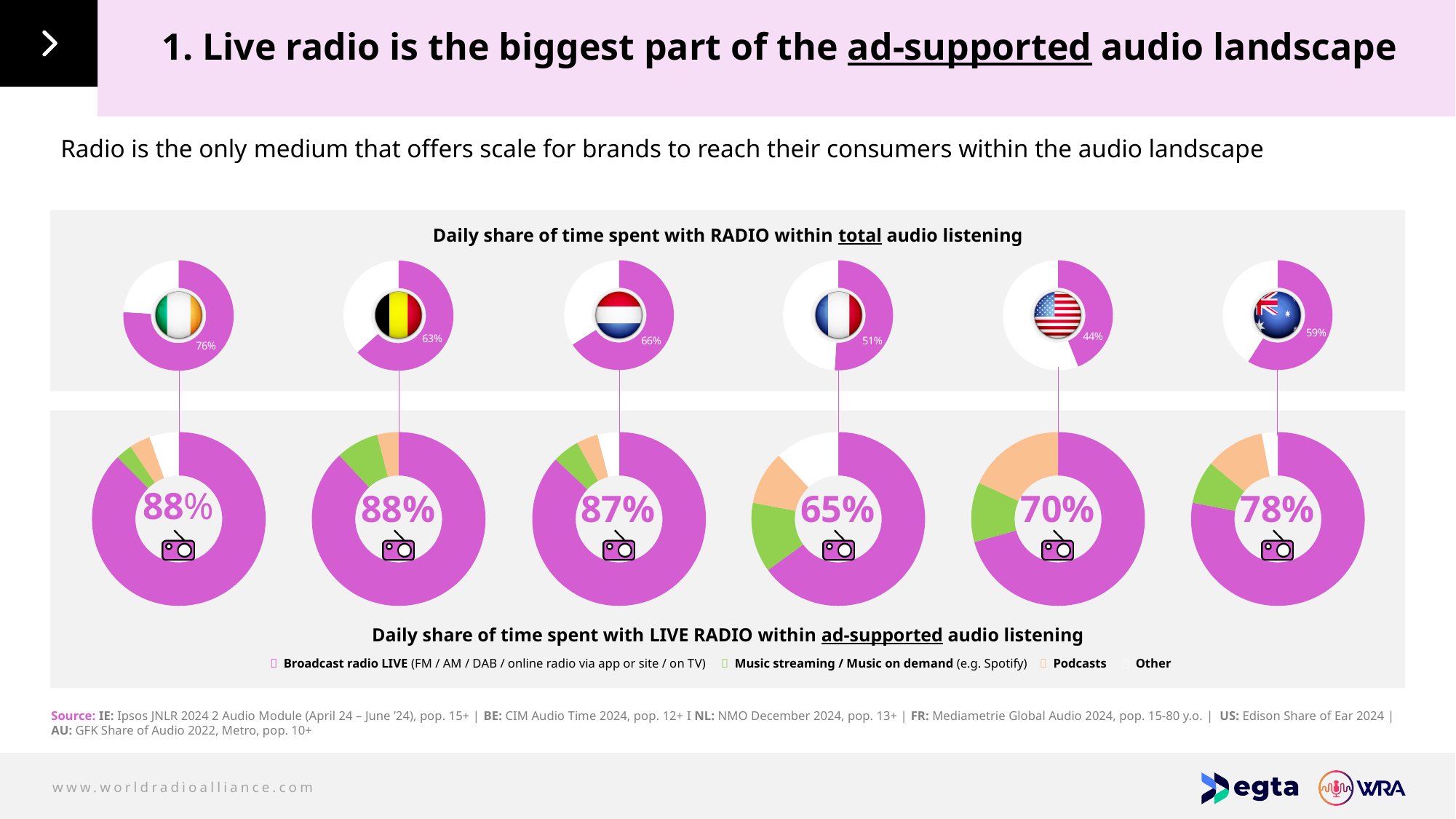
In the bottom row of charts (LIVE RADIO within ad-supported audio listening), which country has the lowest share? France In the top row of charts (RADIO within total audio listening), which country has the lowest share? United States In the top row of charts (RADIO within total audio listening), which country has the highest share? Ireland In the bottom row of charts (LIVE RADIO within ad-supported audio listening), what is the value shown for Australia? 78% What kind of chart is used to show the daily share of time spent with live radio within ad-supported audio listening? Donut (pie) chart In the top row of charts (Daily share of time spent with RADIO within total audio listening), what is the value shown for Ireland? 76% How many categories does the legend below the bottom row of charts list? 4 In the top row of charts (RADIO within total audio listening), what is the value shown for the United States? 44% In the bottom row of charts, what is the difference between the live radio share for Ireland and for the United States? 18 percentage points In the top row of charts, which is larger: the radio share for Belgium or for the Netherlands? Netherlands In the bottom row of charts (LIVE RADIO within ad-supported audio listening), what is the value shown for France? 65% How many countries are shown in the bottom row of charts? 6